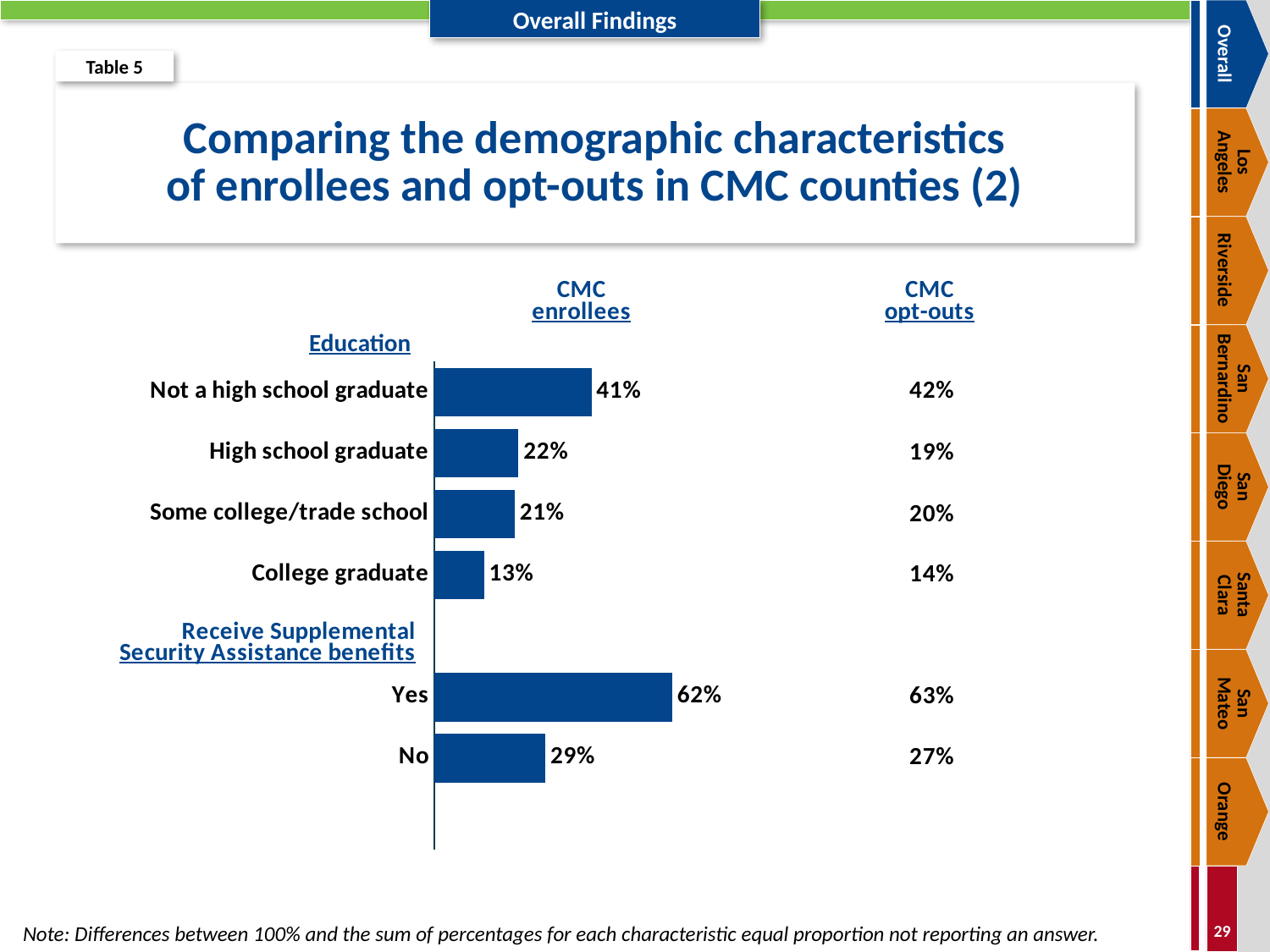
Which is larger for CMC enrollees: the share with some college/trade school or the share who are college graduates? Some college/trade school Which education category has the shortest bar for CMC enrollees? College graduate What percentage of CMC enrollees receive Supplemental Security Assistance benefits (Yes)? 62% What percentage of CMC enrollees are college graduates? 13% What are the two column headings above the data? CMC enrollees and CMC opt-outs Which category has the longest bar for CMC enrollees? Yes (Receive Supplemental Security Assistance benefits) What percentage of CMC opt-outs are high school graduates? 19% What is the difference in percentage points between CMC enrollees who are not a high school graduate and those who are high school graduates? 19 percentage points What kind of chart is shown on the slide? Bar chart What is the difference in percentage points between CMC enrollees and CMC opt-outs who answered No to receiving Supplemental Security Assistance benefits? 2 percentage points What percentage of CMC enrollees are not a high school graduate? 41% How many bars are plotted for CMC enrollees? 6